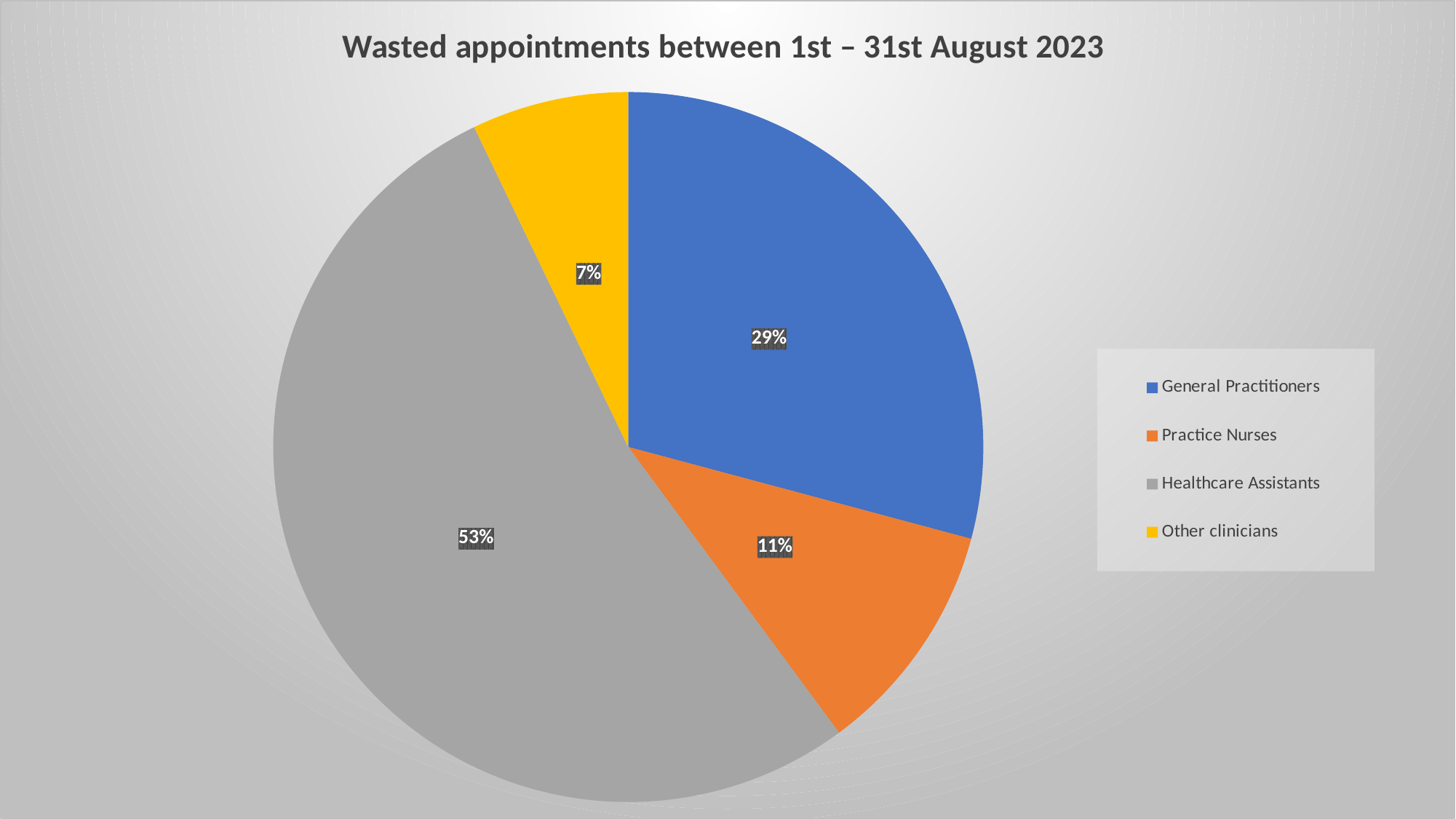
Which has a larger share of wasted appointments, Practice Nurses or Other clinicians? Practice Nurses Which category has the largest share of wasted appointments? Healthcare Assistants What share of wasted appointments is attributed to Healthcare Assistants? 53% What kind of chart is shown on the slide? pie chart What is the difference in percentage points between the Healthcare Assistants share and the General Practitioners share? 24 What share of wasted appointments is attributed to General Practitioners? 29% What is the title of the chart? Wasted appointments between 1st – 31st August 2023 What share of wasted appointments is attributed to Practice Nurses? 11% Which category has the smallest share of wasted appointments? Other clinicians Which colour represents Practice Nurses in the legend? orange How many categories does the pie chart show? 4